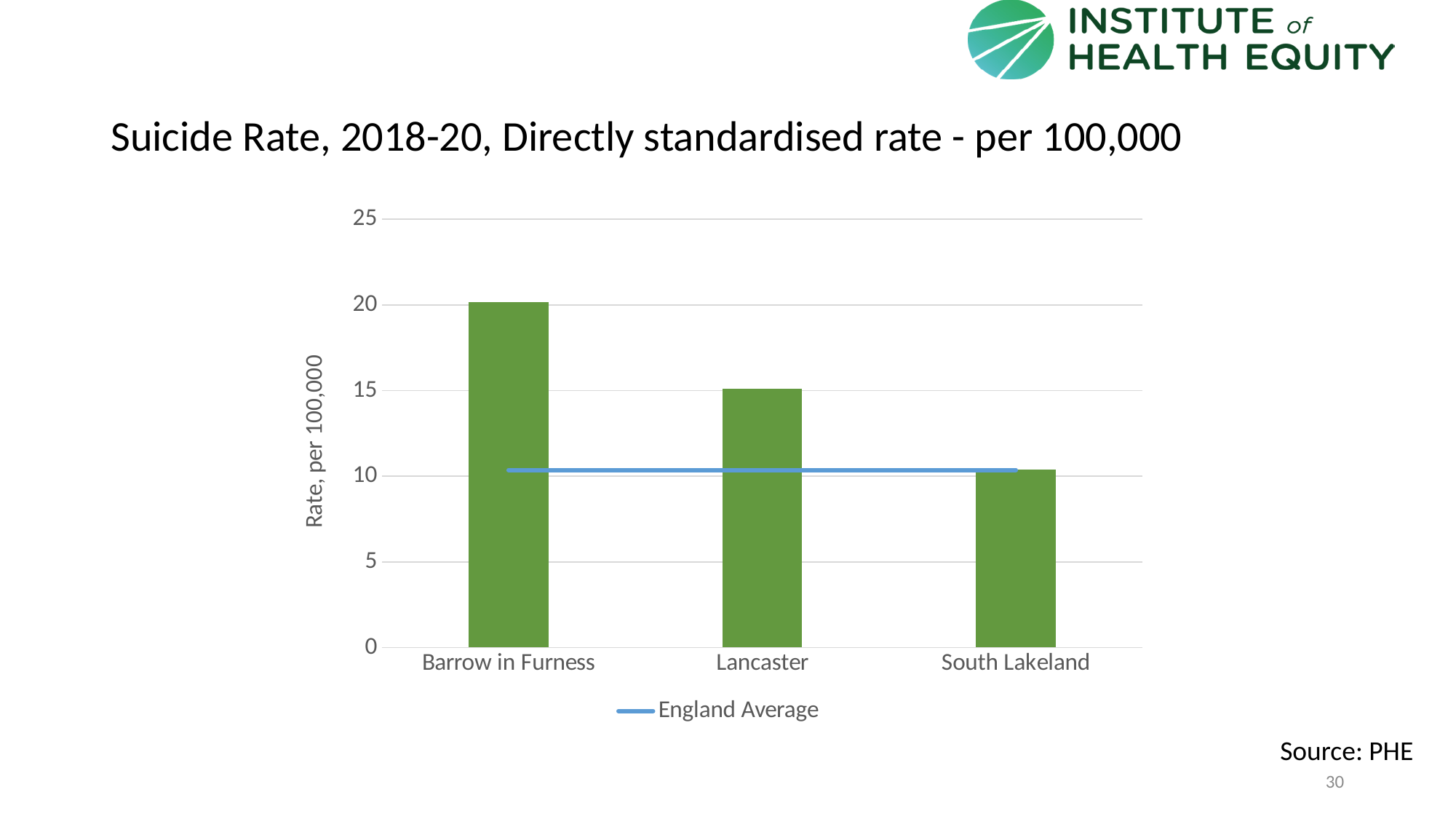
Which has the higher suicide rate, Lancaster or South Lakeland? Lancaster Is the suicide rate for South Lakeland greater or less than 15? less Is the suicide rate for Lancaster greater or less than 20? less How many local areas are shown on the x axis of the chart? 3 Which area has the lowest suicide rate in the chart? South Lakeland Do the bar values rise or fall moving from left to right across the x axis? Fall Is the suicide rate for Lancaster greater or less than 10? greater What does the horizontal blue line in the chart represent, according to the legend? England Average What kind of chart is shown on the slide? Bar chart Which has the higher suicide rate, Barrow in Furness or Lancaster? Barrow in Furness Which area has the highest suicide rate in the chart? Barrow in Furness